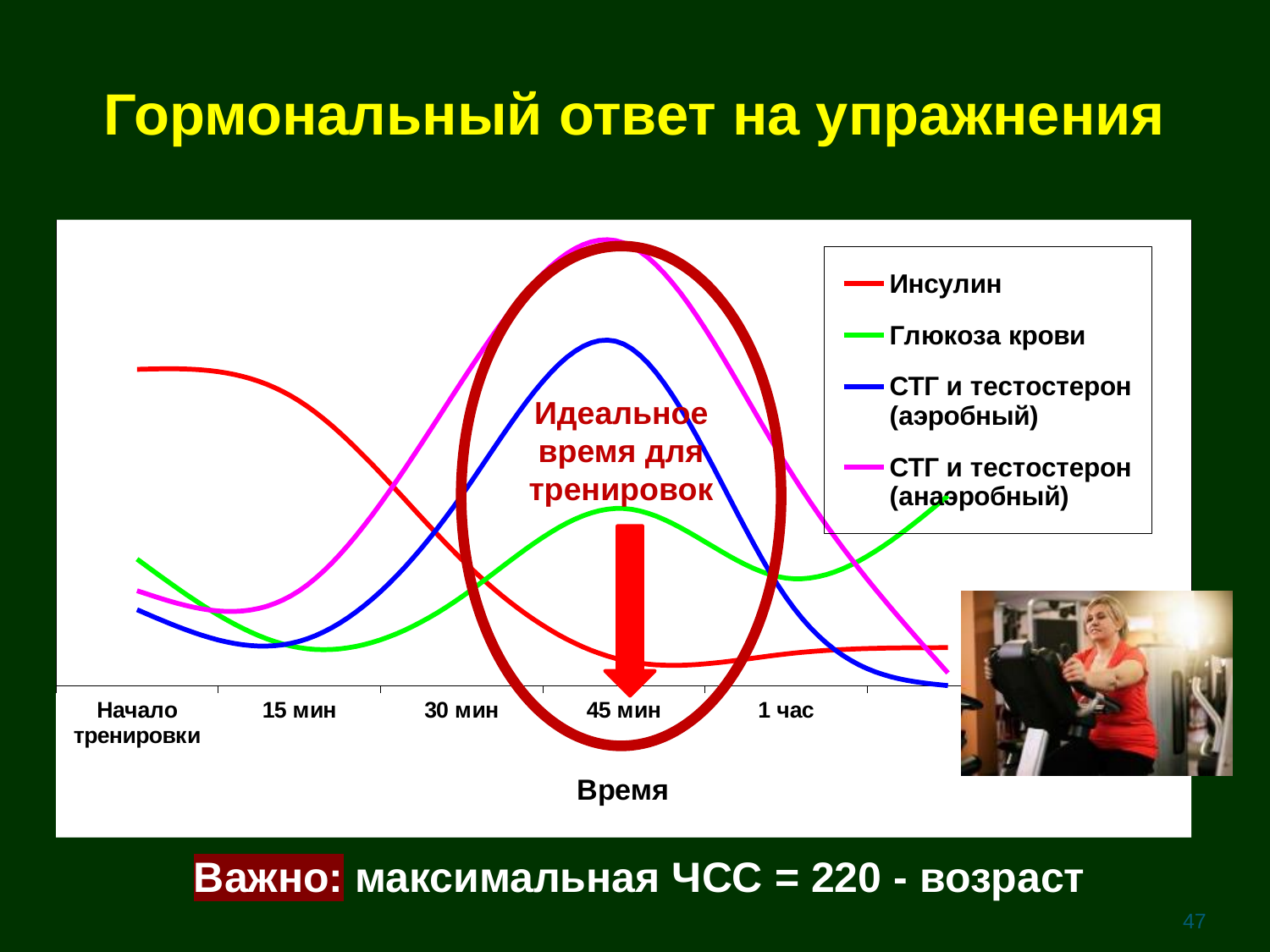
At 45 мин, which is higher: Инсулин or Глюкоза крови? Глюкоза крови How many labelled time points are shown on the x axis? 5 How many series does the legend list? 4 What kind of chart is shown on the slide? line chart Which series is drawn in red according to the legend? Инсулин Does the Глюкоза крови line rise or fall from 15 мин to 45 мин? rise Does the СТГ и тестостерон (анаэробный) line rise or fall from 45 мин to 1 час? fall Which series reaches the highest peak on the chart? СТГ и тестостерон (анаэробный) Which series is highest at the start of the workout (Начало тренировки)? Инсулин At 45 мин, which is higher: СТГ и тестостерон (аэробный) or СТГ и тестостерон (анаэробный)? СТГ и тестостерон (анаэробный) What is the title of the x axis? Время Does the Инсулин line rise or fall from the start of the workout to 45 мин? fall